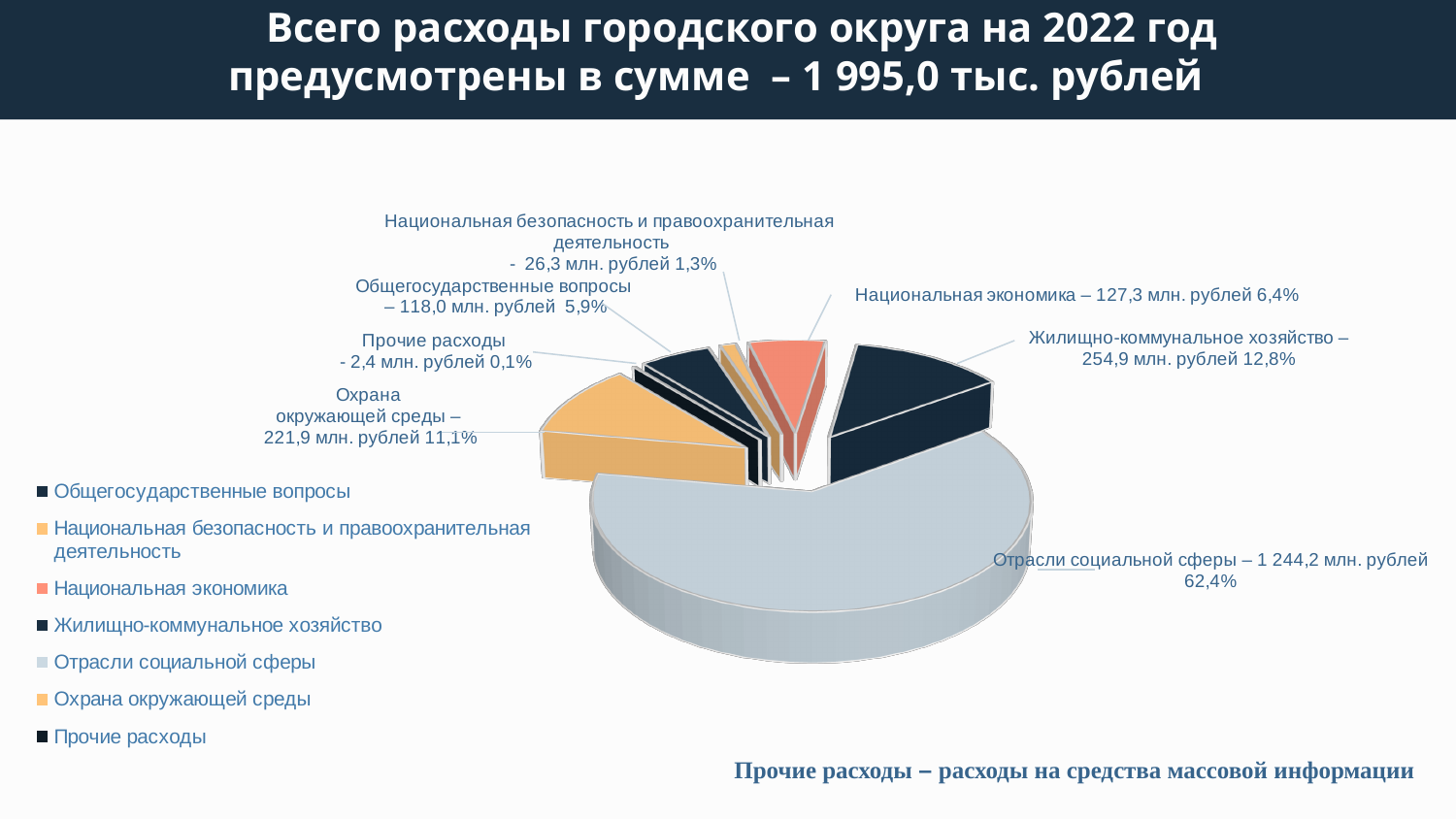
What amount is shown for Отрасли социальной сферы? 1 244,2 млн. рублей Which category has the smallest slice of the pie? Прочие расходы How many slices does the pie chart have? 7 What is the difference in percentage points between Жилищно-коммунальное хозяйство (12,8%) and Охрана окружающей среды (11,1%)? 1,7 What share of the pie does Национальная безопасность и правоохранительная деятельность have? 1,3% What amount is shown for Охрана окружающей среды? 221,9 млн. рублей What total amount of expenses for 2022 is stated in the slide title? 1 995,0 тыс. рублей What kind of chart is shown on the slide? pie chart Which is larger: Национальная экономика or Общегосударственные вопросы? Национальная экономика What share of the pie does Жилищно-коммунальное хозяйство have? 12,8% How many entries does the legend list? 7 Which category has the largest slice of the pie? Отрасли социальной сферы